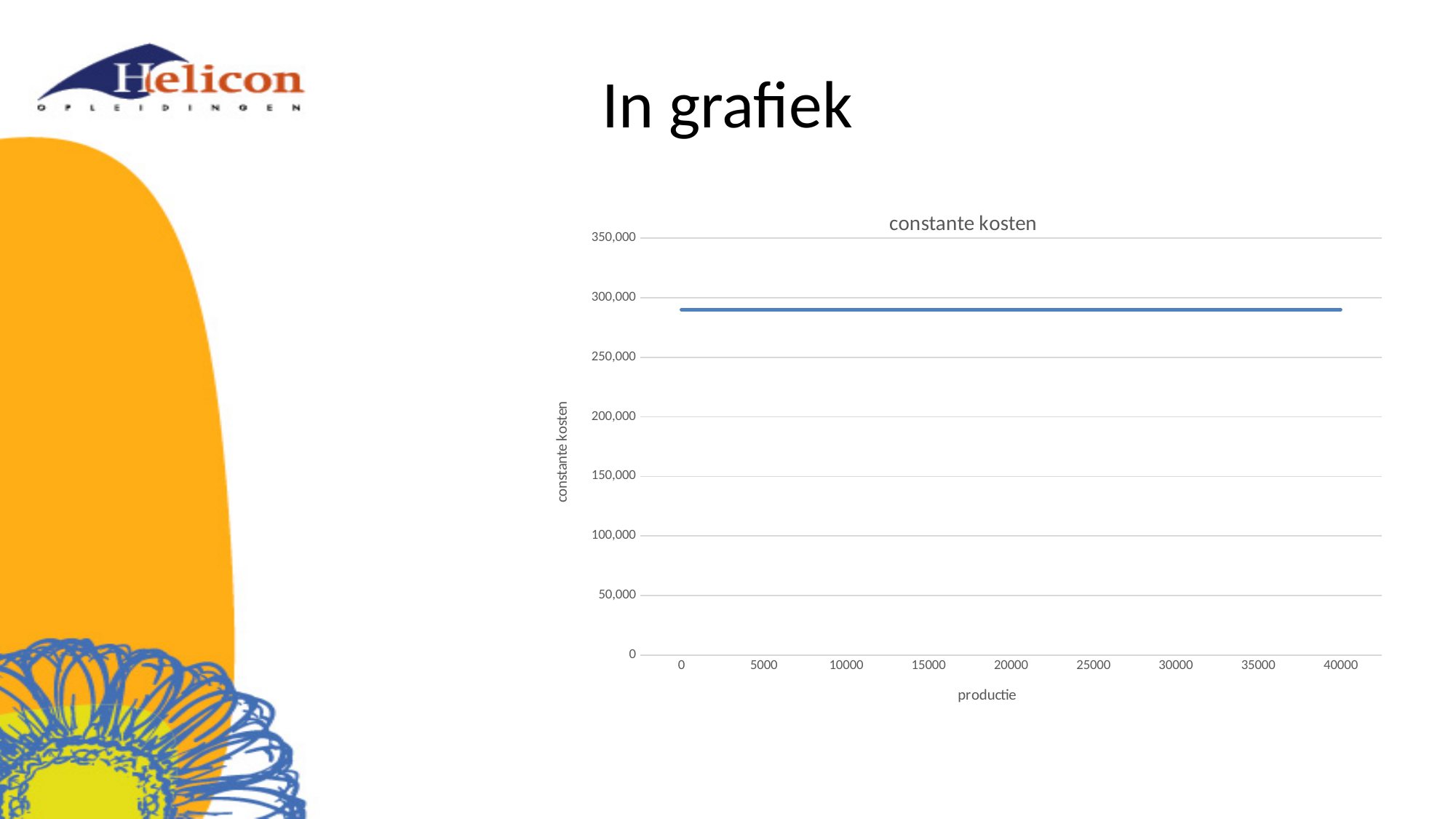
What is the highest value shown on the vertical axis of the chart? 350,000 Is the value of constante kosten at a productie of 20000 greater or less than 300,000? less What kind of chart is shown on the slide? line chart What is the title of the chart? constante kosten Is the value of constante kosten at a productie of 40000 greater or less than 200,000? greater Is the value of constante kosten at a productie of 0 greater or less than 250,000? greater Does the value of constante kosten rise, fall or stay flat as productie increases from 0 to 40000? stays flat What is the label of the horizontal axis of the chart? productie